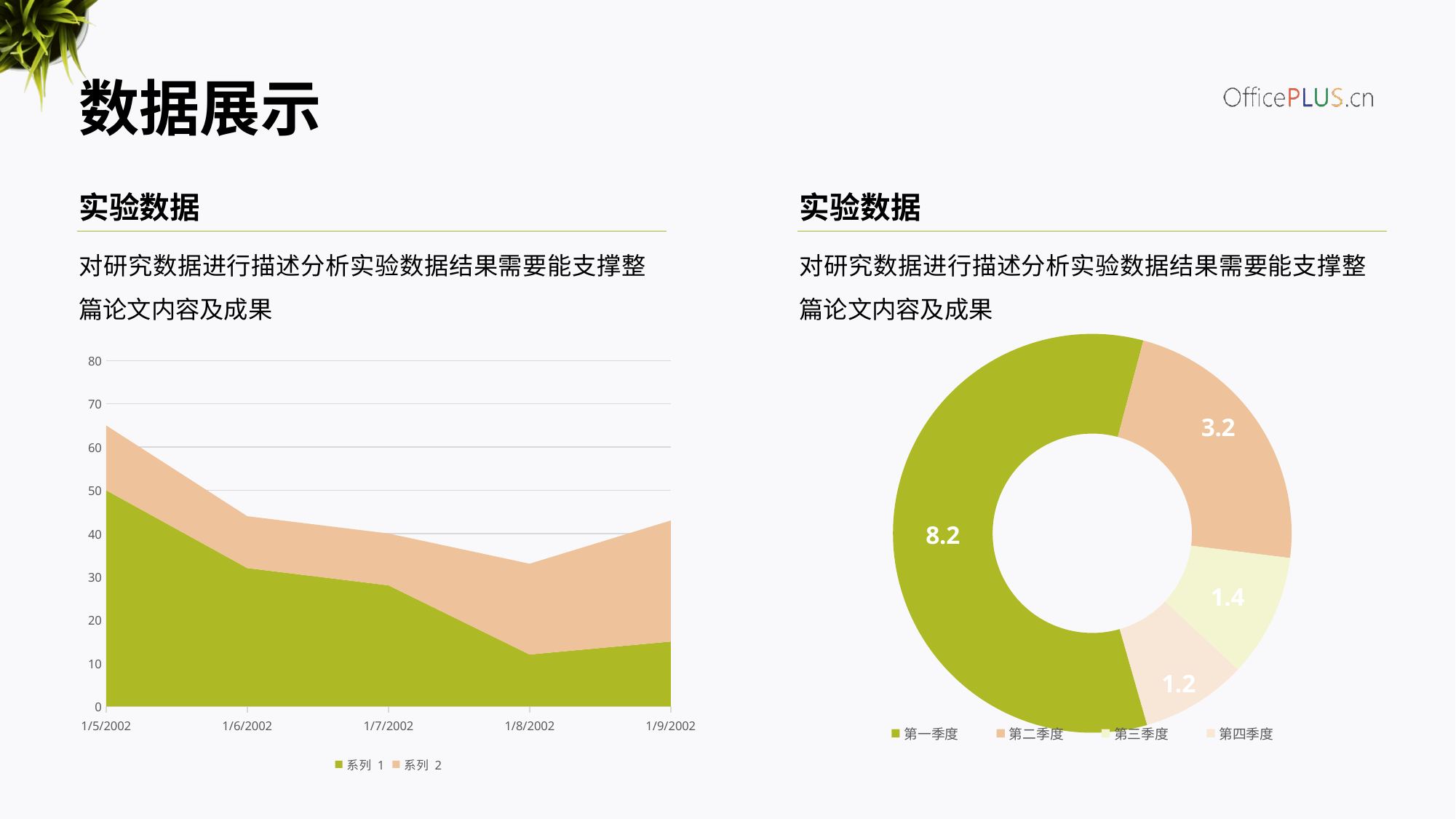
In the doughnut chart on the right, what is the difference between the values for 第一季度 and 第二季度? 5.0 In the area chart on the left, how many series does the legend list? 2 In the doughnut chart on the right, which quarter has the smallest value? 第四季度 In the doughnut chart on the right, how many categories does the legend list? 4 What kind of chart is shown on the left side of the slide? Stacked area chart In the area chart on the left, is the value for 系列 1 at 1/8/2002 greater or less than 20? less In the area chart on the left, how many dates are shown on the x axis? 5 In the doughnut chart on the right, what is the value for 第一季度? 8.2 In the area chart on the left, is the value for 系列 1 at 1/5/2002 greater or less than 40? greater What kind of chart is shown on the right side of the slide? Doughnut chart In the doughnut chart on the right, what is the value for 第三季度? 1.4 In the area chart on the left, does 系列 1 generally rise or fall from 1/5/2002 to 1/8/2002? fall